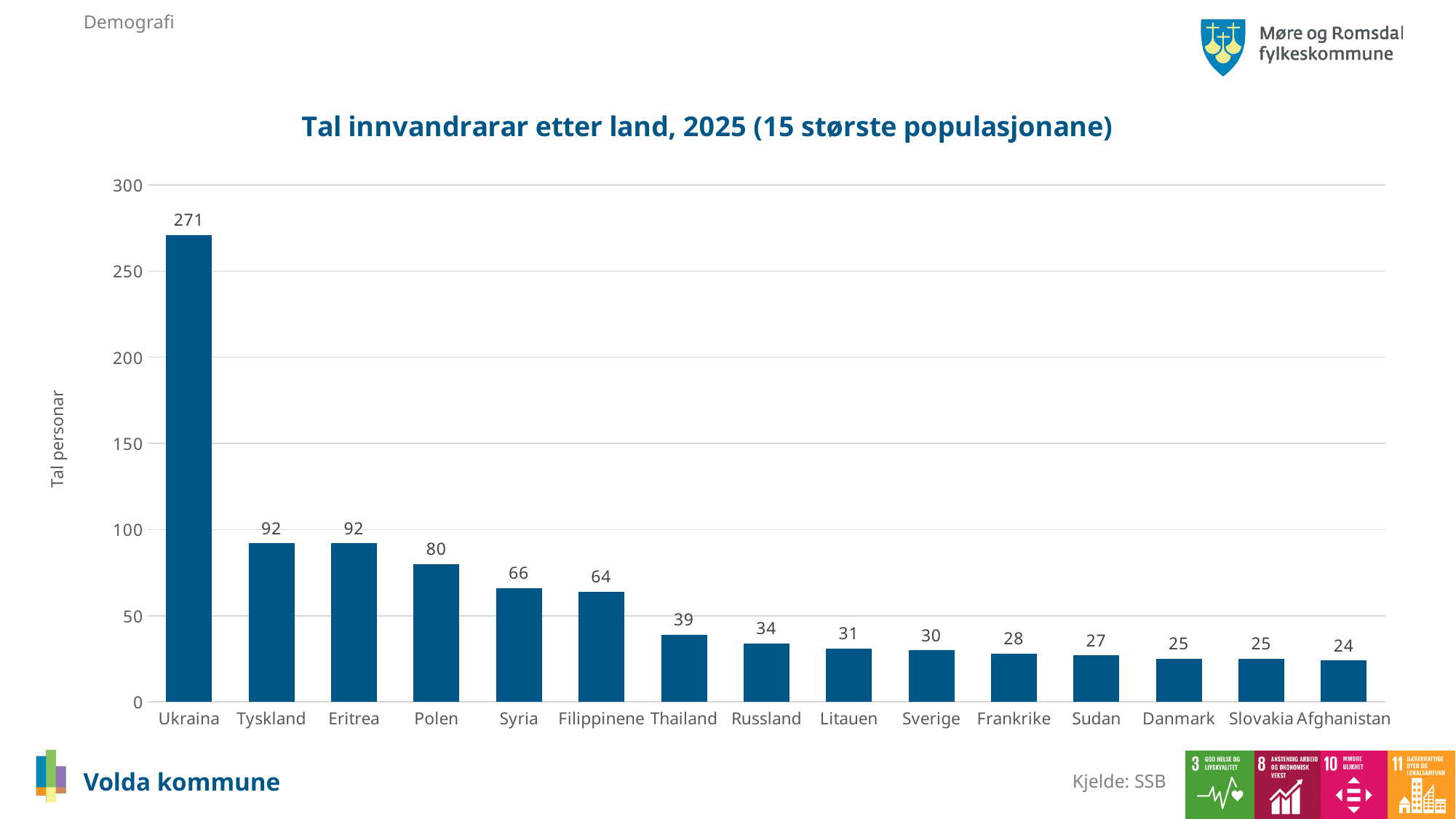
What is the value for Ukraina? 271 Is the value for Ukraina greater or less than 250? greater What is the difference between the values for Syria and Filippinene? 2 Which country has the lowest value? Afghanistan How many countries are shown on the chart? 15 Which is larger, the value for Polen or the value for Syria? Polen What kind of chart is shown on the slide? bar chart What is the title of the chart? Tal innvandrarar etter land, 2025 (15 største populasjonane) What is the value for Thailand? 39 Which country has the highest value? Ukraina What is the value for Polen? 80 What is the difference between the values for Ukraina and Tyskland? 179